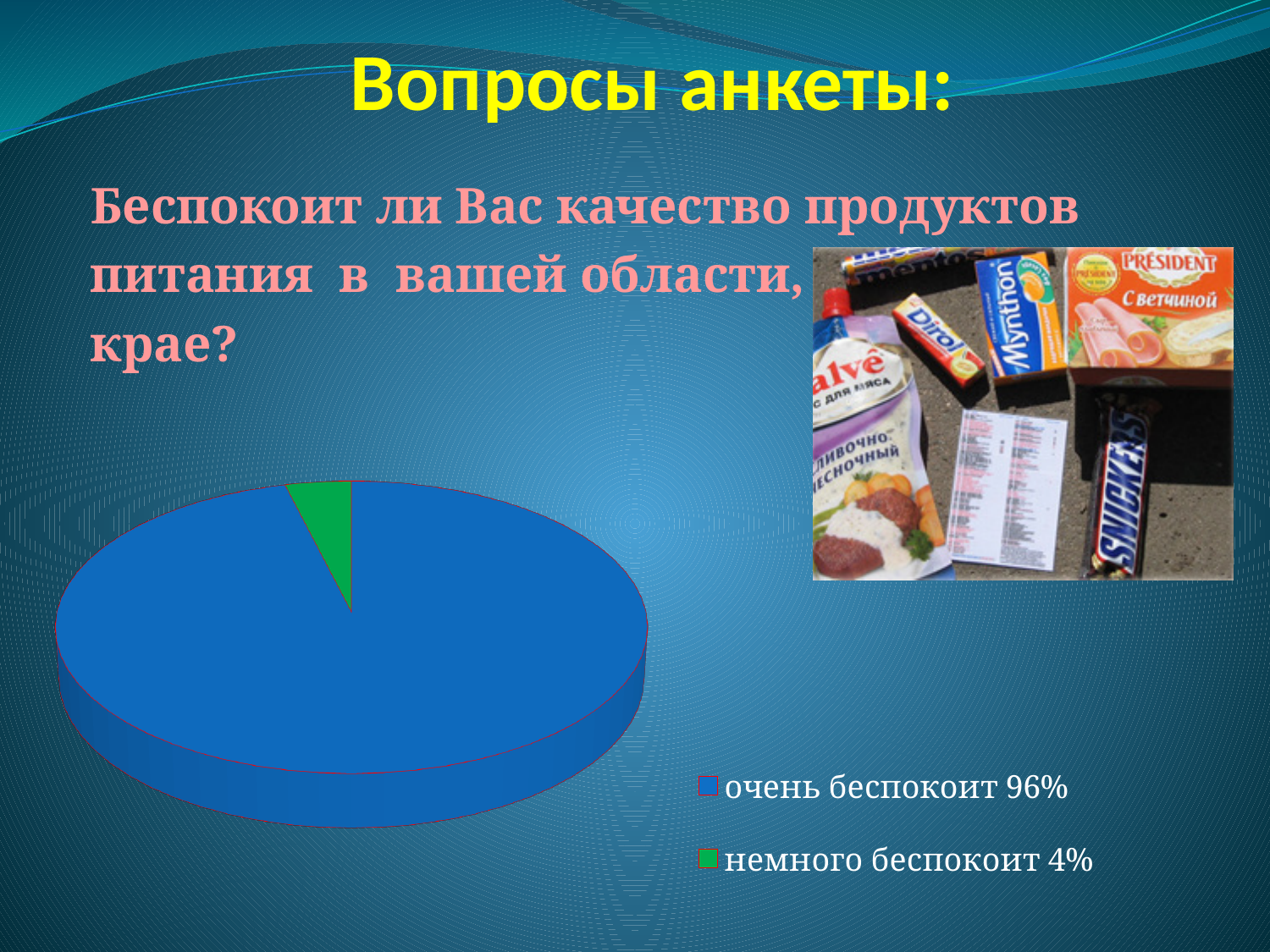
Which category has the largest slice of the pie? очень беспокоит Which category has the smallest slice of the pie? немного беспокоит How many entries does the legend of the pie chart list? 2 Which is larger: the share for "очень беспокоит" or the share for "немного беспокоит"? очень беспокоит What share of the pie is labelled "очень беспокоит"? 96% What share of the pie is labelled "немного беспокоит"? 4% How many slices does the pie chart have? 2 What colour is the slice for "немного беспокоит"? green What kind of chart is shown on the slide? pie chart What is the difference in percentage points between the "очень беспокоит" and "немного беспокоит" slices? 92 What colour is the slice for "очень беспокоит"? blue